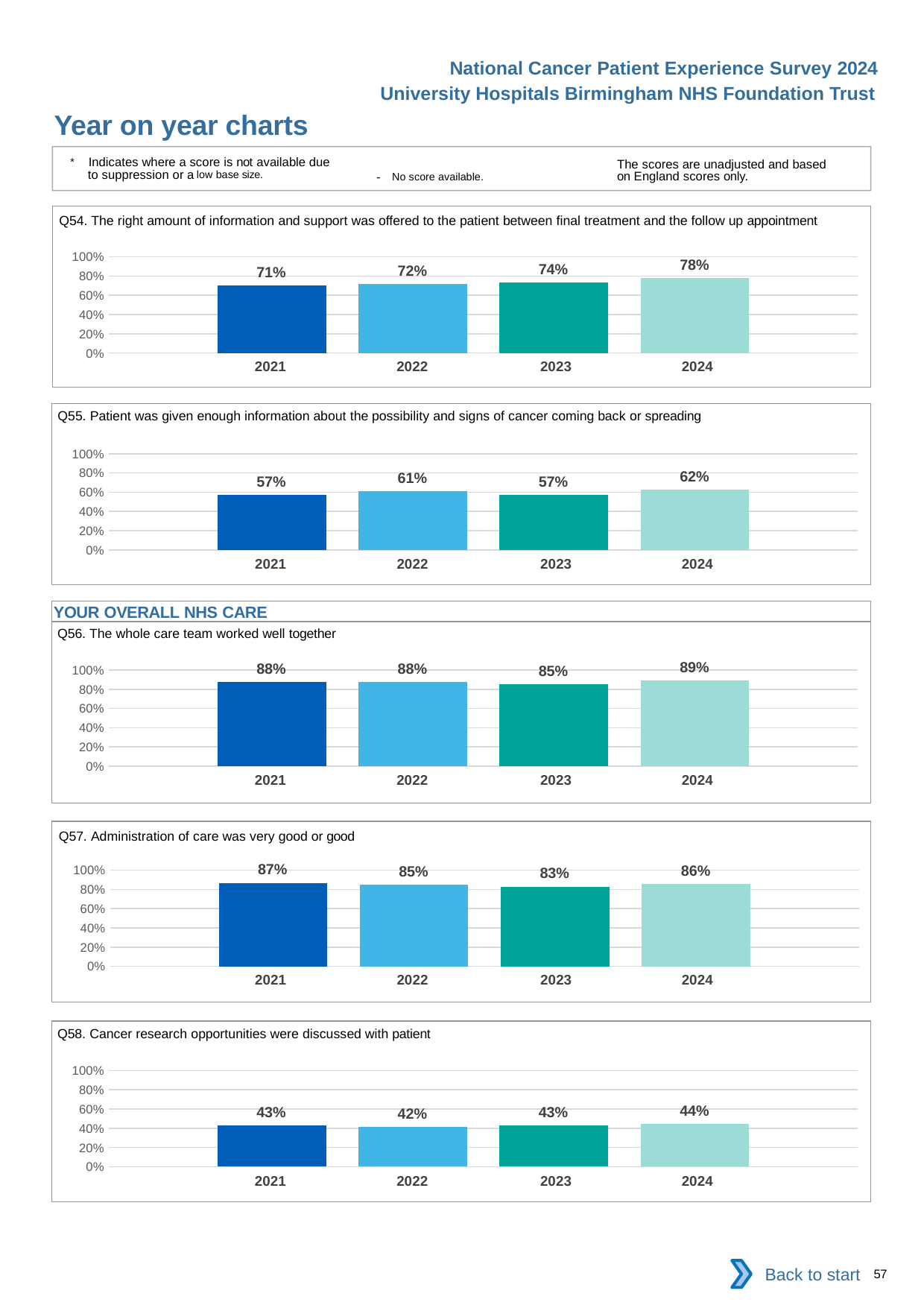
In the Q58 chart, what is the value for 2022? 42% In the Q54 chart, what is the value for 2024? 78% What kind of chart is the Q58 chart? bar chart In the Q57 chart, which is larger, the value for 2021 or the value for 2024? 2021 In the Q54 chart, do the values rise or fall from 2021 to 2024? rise How many charts are shown on the slide? 5 In the Q55 chart, which year has the highest value? 2024 In the Q57 chart, what is the difference between the 2021 and 2023 values? 4% In the Q56 chart, what is the value for 2023? 85% In the Q58 chart, how many years are plotted? 4 In the Q56 chart, which year has the lowest value? 2023 In the Q55 chart, what is the difference between the 2022 and 2021 values? 4%